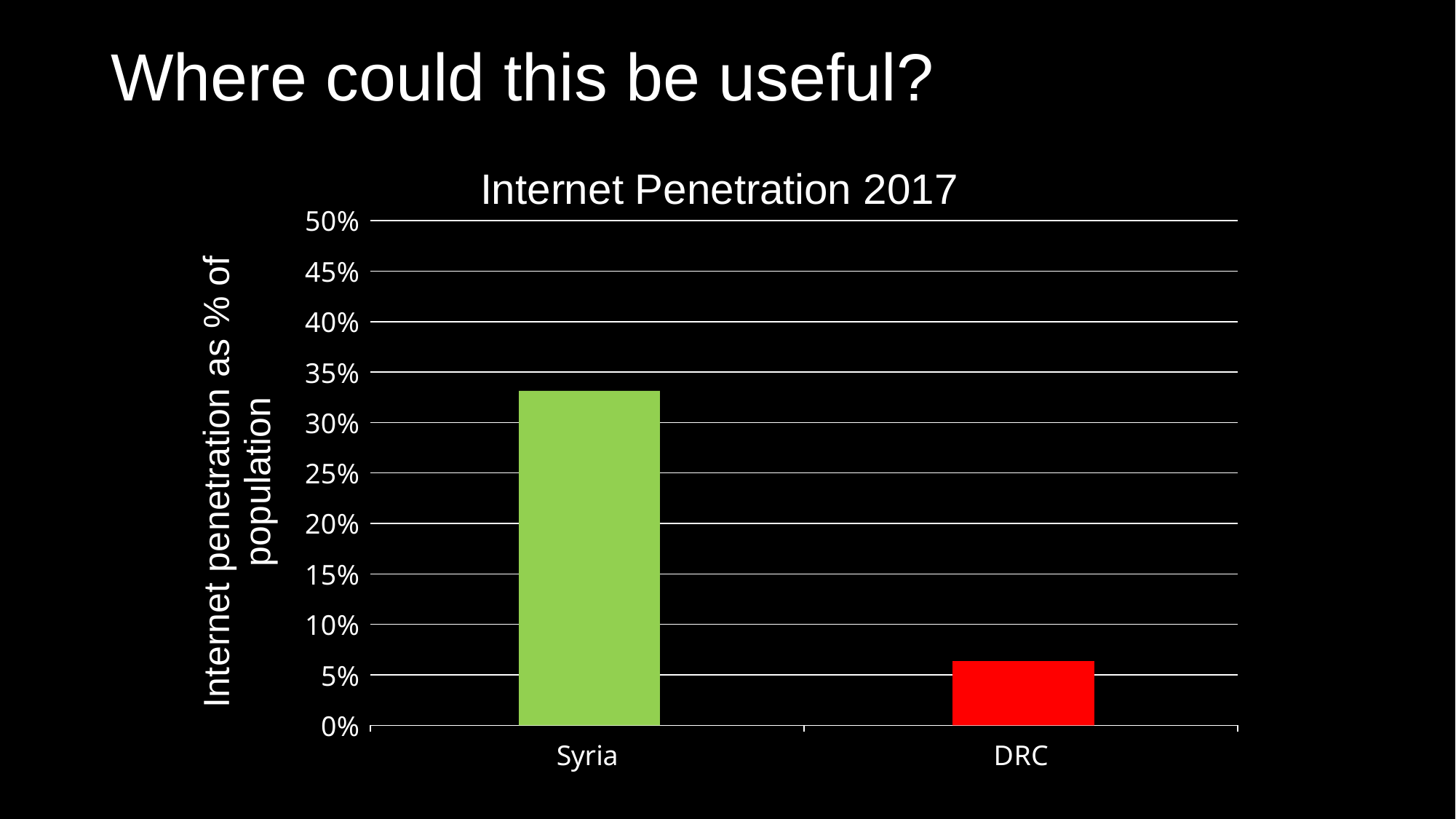
What is the label on the vertical axis? Internet penetration as % of population How many countries are shown in the chart? 2 Is the value for DRC greater or less than 10%? less What is the title of the chart? Internet Penetration 2017 Is the value for Syria greater or less than 35%? less What kind of chart is shown on the slide? bar chart Which country has the lowest internet penetration? DRC What is the maximum value shown on the vertical axis? 50% Is the value for Syria greater or less than 30%? greater Which country has the highest internet penetration? Syria Which has a larger internet penetration, Syria or DRC? Syria